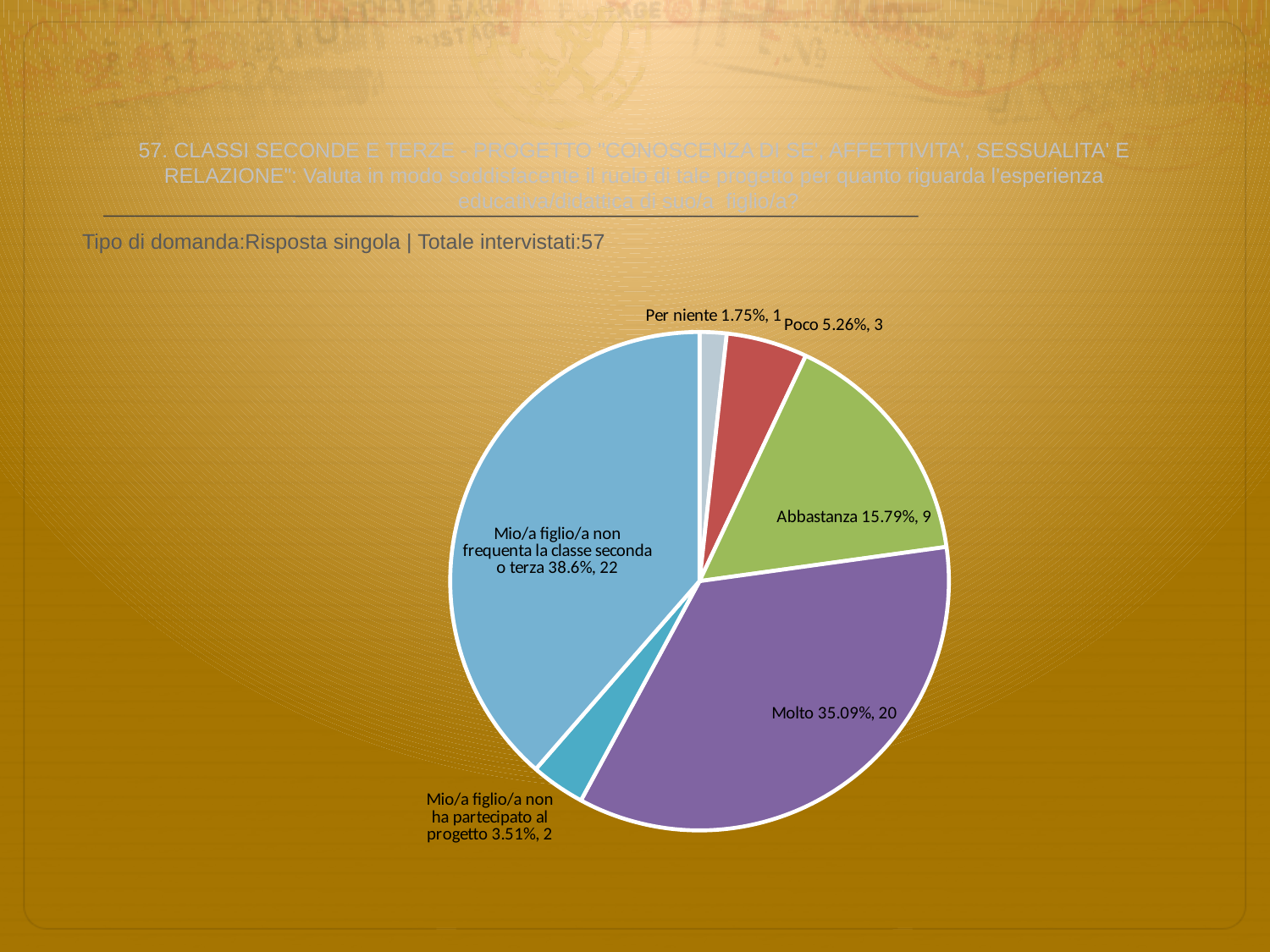
What is the total number of respondents (Totale intervistati) stated on the slide? 57 Which is larger, the "Abbastanza" slice or the "Poco" slice? Abbastanza How many slices does the pie chart have? 6 What percentage share does the "Molto" slice have? 35.09% What is the difference in count between "Mio/a figlio/a non frequenta la classe seconda o terza" and "Molto"? 2 What percentage share does the "Per niente" slice have? 1.75% How many respondents answered "Mio/a figlio/a non ha partecipato al progetto"? 2 Which category has the largest slice of the pie? Mio/a figlio/a non frequenta la classe seconda o terza What percentage share does the "Poco" slice have? 5.26% How many respondents answered "Abbastanza"? 9 What kind of chart is shown on the slide? pie chart Which category has the smallest slice of the pie? Per niente